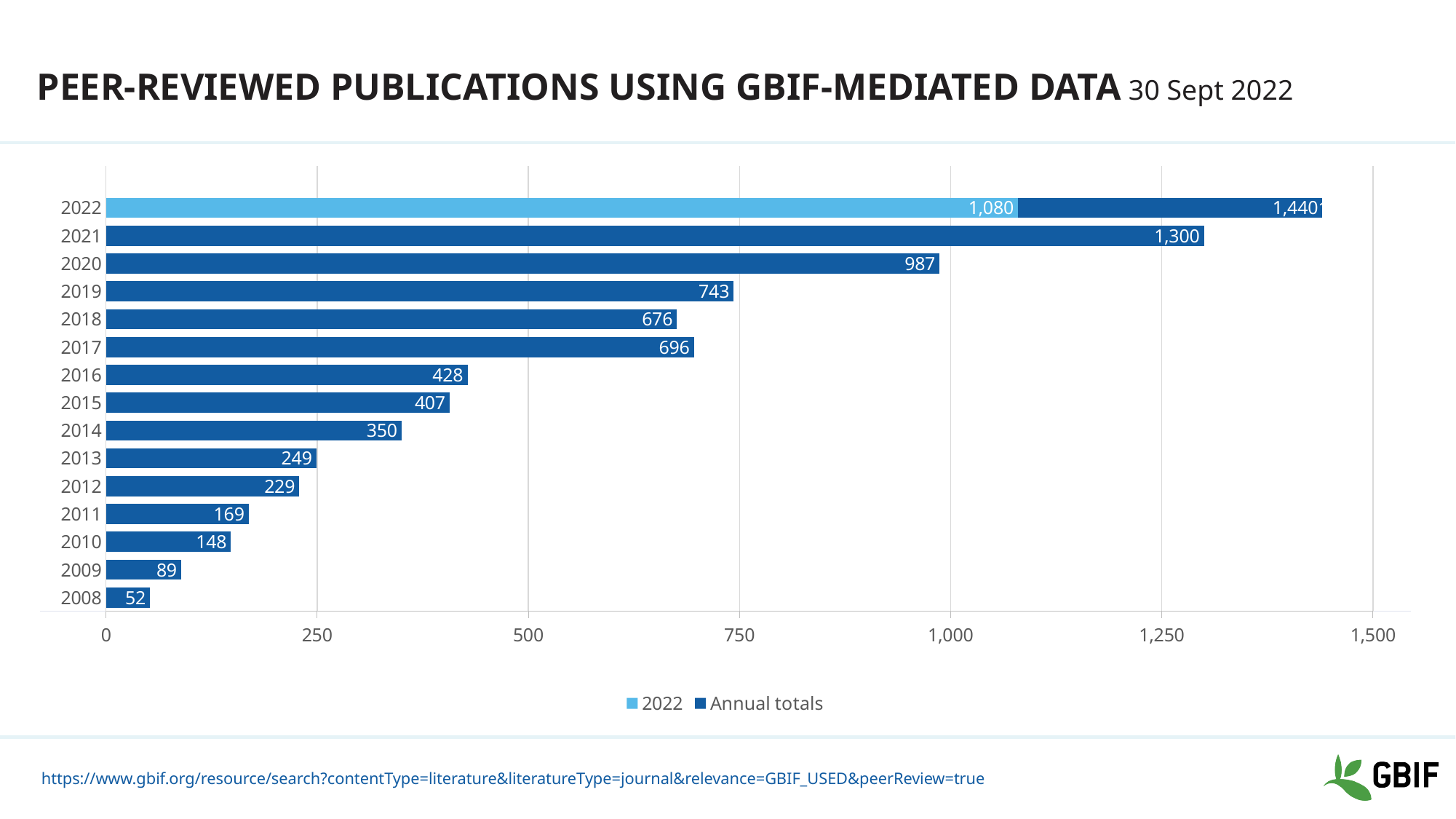
What is the value shown for 2021? 1,300 What is the value shown for 2017? 696 What kind of chart is shown on the slide? Bar chart Is the value for 2014 greater or less than 250? greater How many years are shown on the chart? 15 Which year has the longest bar? 2022 What is the value shown for 2008? 52 How many series does the legend list? 2 What is the difference between the values for 2021 and 2020? 313 Which year has the larger value, 2017 or 2018? 2017 Which year has the smallest value? 2008 What value is printed on the light blue '2022' segment of the 2022 bar? 1,080